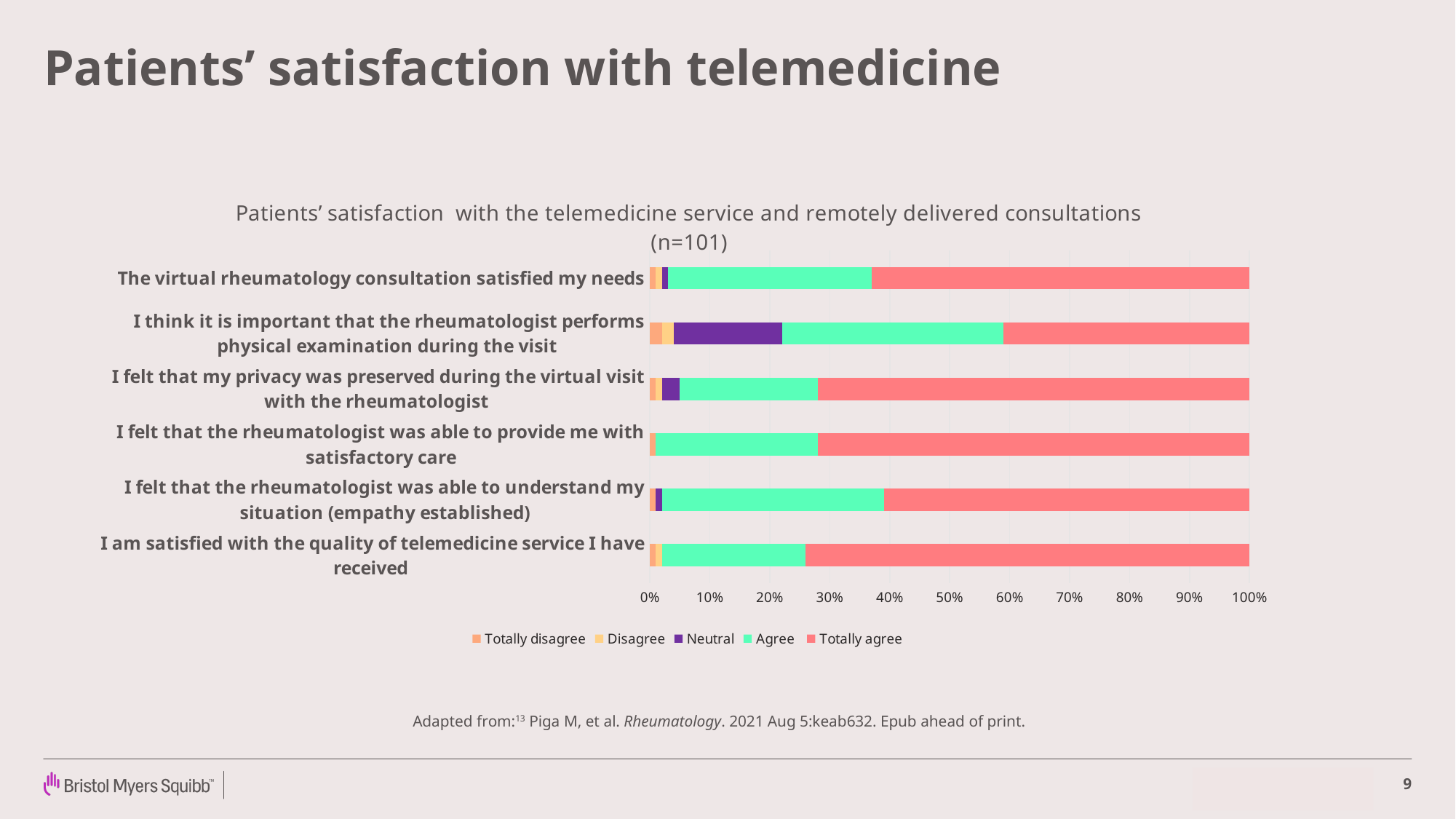
What kind of chart is shown on the slide? Stacked bar chart What is the sample size given in the chart title? n=101 Which statement has the smallest Totally agree segment? I think it is important that the rheumatologist performs physical examination during the visit Which statement has the largest Neutral segment? I think it is important that the rheumatologist performs physical examination during the visit What is the total of each stacked bar, as shown by where the bars end on the x axis? 100% Which response category is shown in purple in the legend? Neutral How many statements (categories) are plotted in the chart? 6 Is the Neutral share for 'I think it is important that the rheumatologist performs physical examination during the visit' greater or less than 10%? greater Is the Totally agree share for 'I think it is important that the rheumatologist performs physical examination during the visit' greater or less than 50%? less Is the Totally agree share for 'The virtual rheumatology consultation satisfied my needs' greater or less than 50%? greater Which has the larger Totally agree segment: 'The virtual rheumatology consultation satisfied my needs' or 'I think it is important that the rheumatologist performs physical examination during the visit'? The virtual rheumatology consultation satisfied my needs How many response categories does the legend list? 5